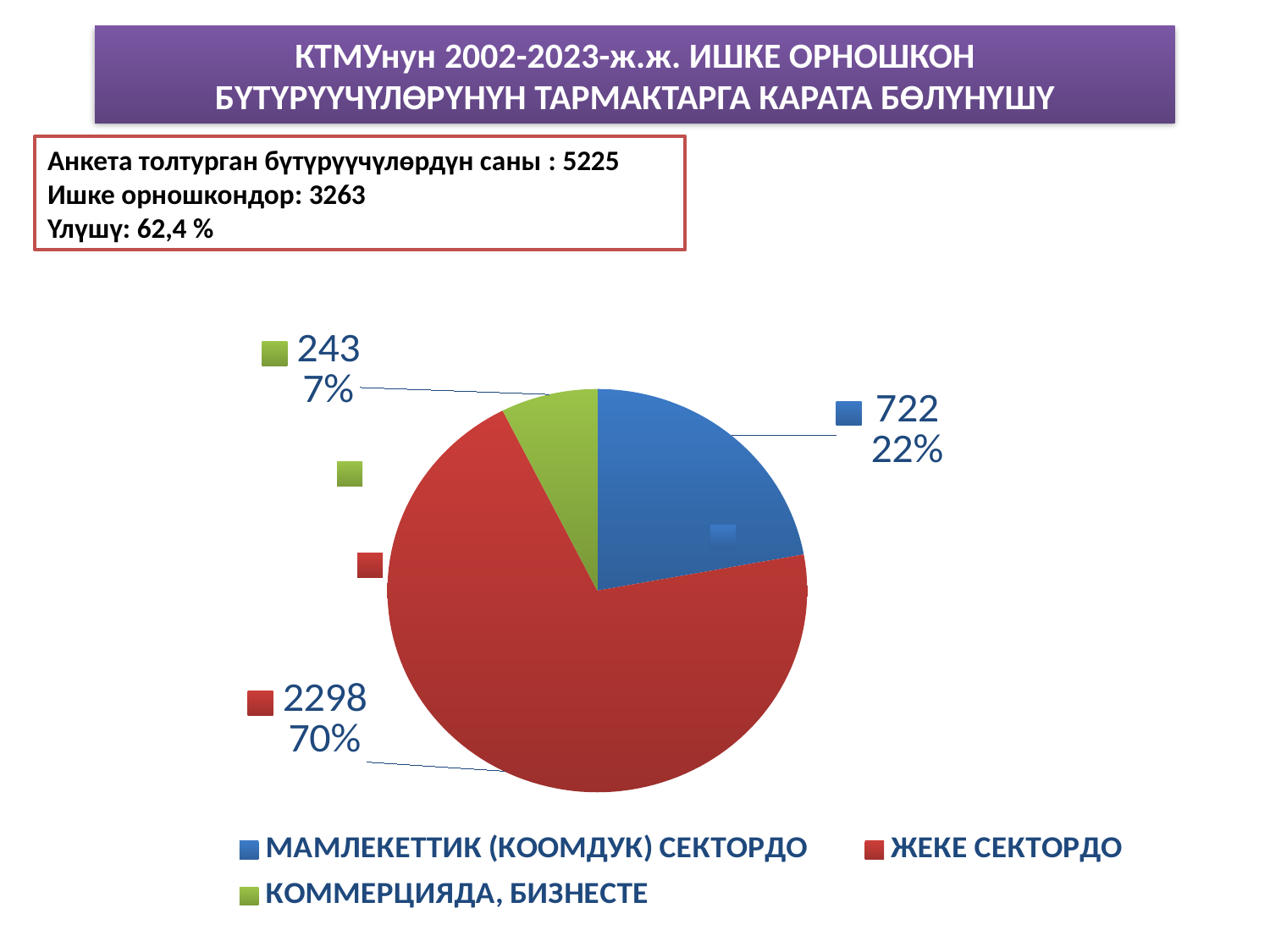
What is the difference between the values for ЖЕКЕ СЕКТОРДО and МАМЛЕКЕТТИК (КООМДУК) СЕКТОРДО? 1576 Which category has the smallest slice? КОММЕРЦИЯДА, БИЗНЕСТЕ Which category has the largest slice? ЖЕКЕ СЕКТОРДО What is the value for КОММЕРЦИЯДА, БИЗНЕСТЕ? 243 What share of the pie does КОММЕРЦИЯДА, БИЗНЕСТЕ represent? 7% What is the value for МАМЛЕКЕТТИК (КООМДУК) СЕКТОРДО? 722 How many entries does the legend list? 3 What is the value for ЖЕКЕ СЕКТОРДО? 2298 Which colour represents ЖЕКЕ СЕКТОРДО in the pie chart? red What share of the pie does ЖЕКЕ СЕКТОРДО represent? 70% How many slices does the pie chart have? 3 What kind of chart is shown on the slide? pie chart